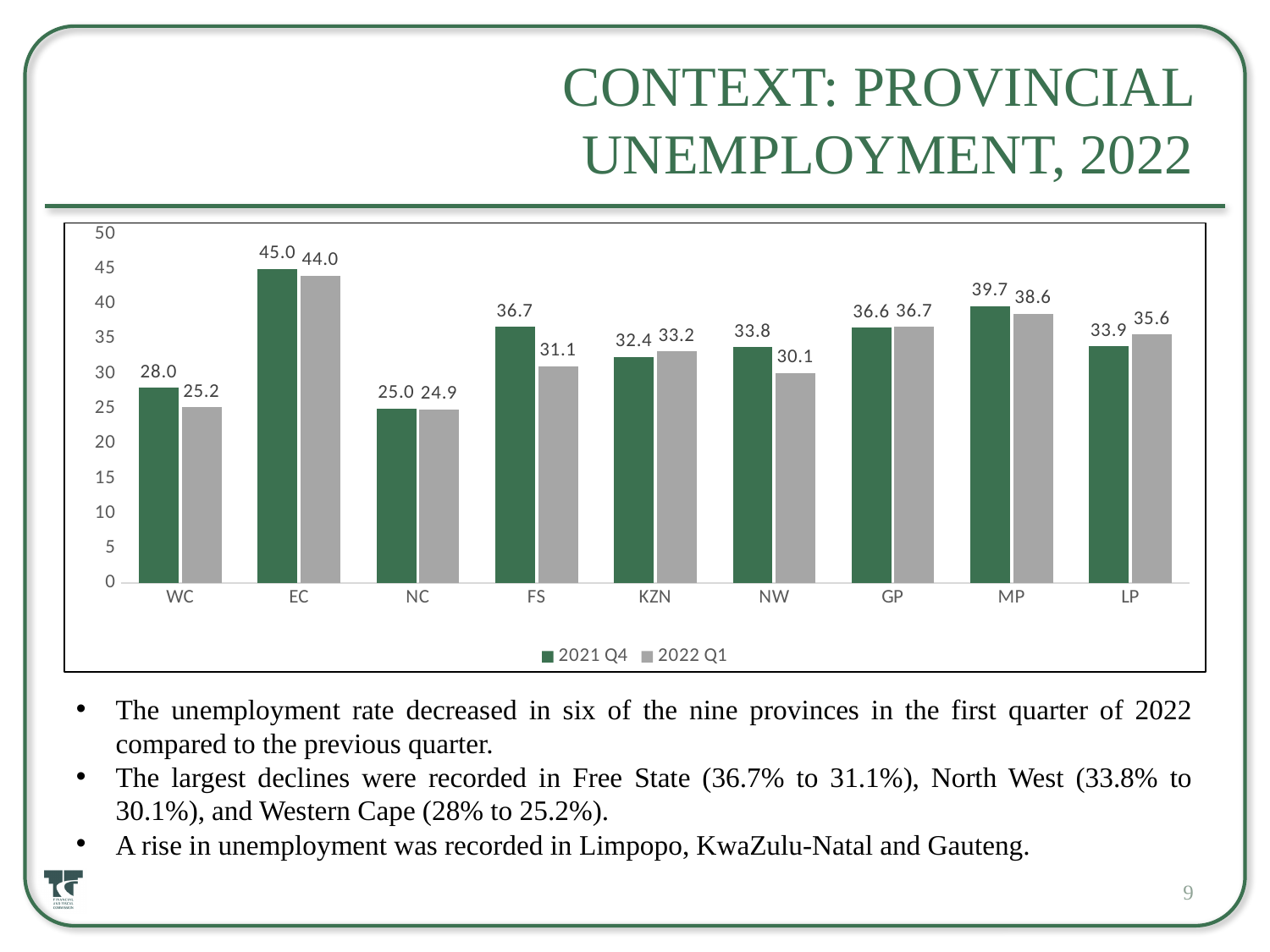
What is the 2022 Q1 value for FS? 31.1 What is the 2022 Q1 value for LP? 35.6 What is the 2021 Q4 value for EC? 45.0 Is the 2022 Q1 value for MP greater or less than 35? greater What is the difference between the 2021 Q4 and 2022 Q1 values for FS? 5.6 Which province has the highest 2022 Q1 value? EC How many series does the legend list? 2 Which province has the lowest 2021 Q4 value? NC What is the difference between the 2021 Q4 and 2022 Q1 values for NW? 3.7 What kind of chart is shown on the slide? Bar chart How many provinces are shown on the x axis? 9 Which is larger for KZN: the 2021 Q4 value or the 2022 Q1 value? 2022 Q1